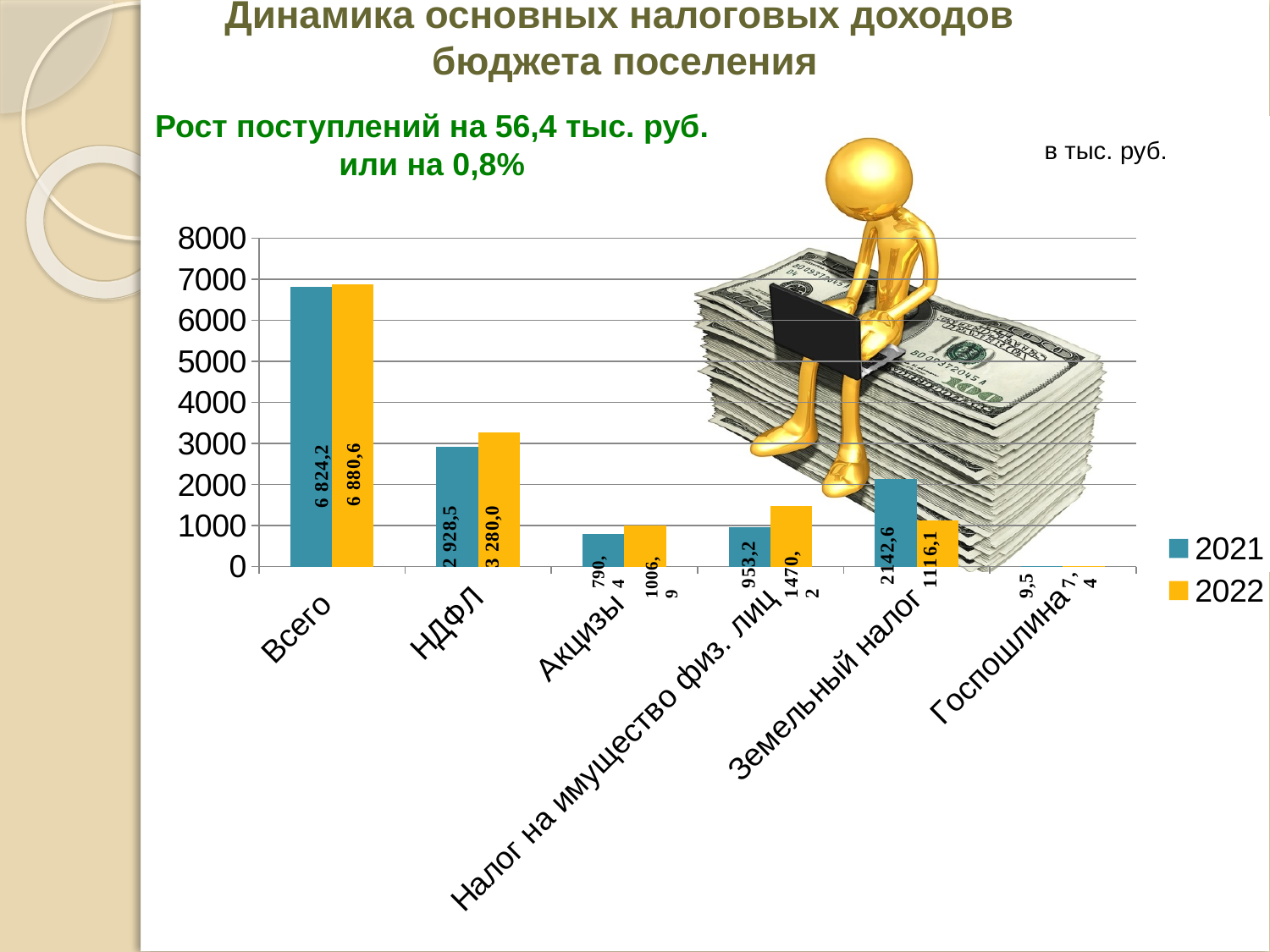
What is the value for Всего in 2022? 6 880,6 Which series is shown in yellow in the legend? 2022 What kind of chart is shown on the slide? bar chart How many series does the legend list? 2 Which category has the lowest value in 2021? Госпошлина What is the value for Земельный налог in 2021? 2142,6 What is the value for Всего in 2021? 6 824,2 Which is larger for Земельный налог: the 2021 value or the 2022 value? 2021 How many categories are shown on the x axis? 6 What is the value for НДФЛ in 2022? 3 280,0 What is the value for Налог на имущество физ. лиц in 2021? 953,2 What is the difference between the 2022 and 2021 values for НДФЛ? 351,5